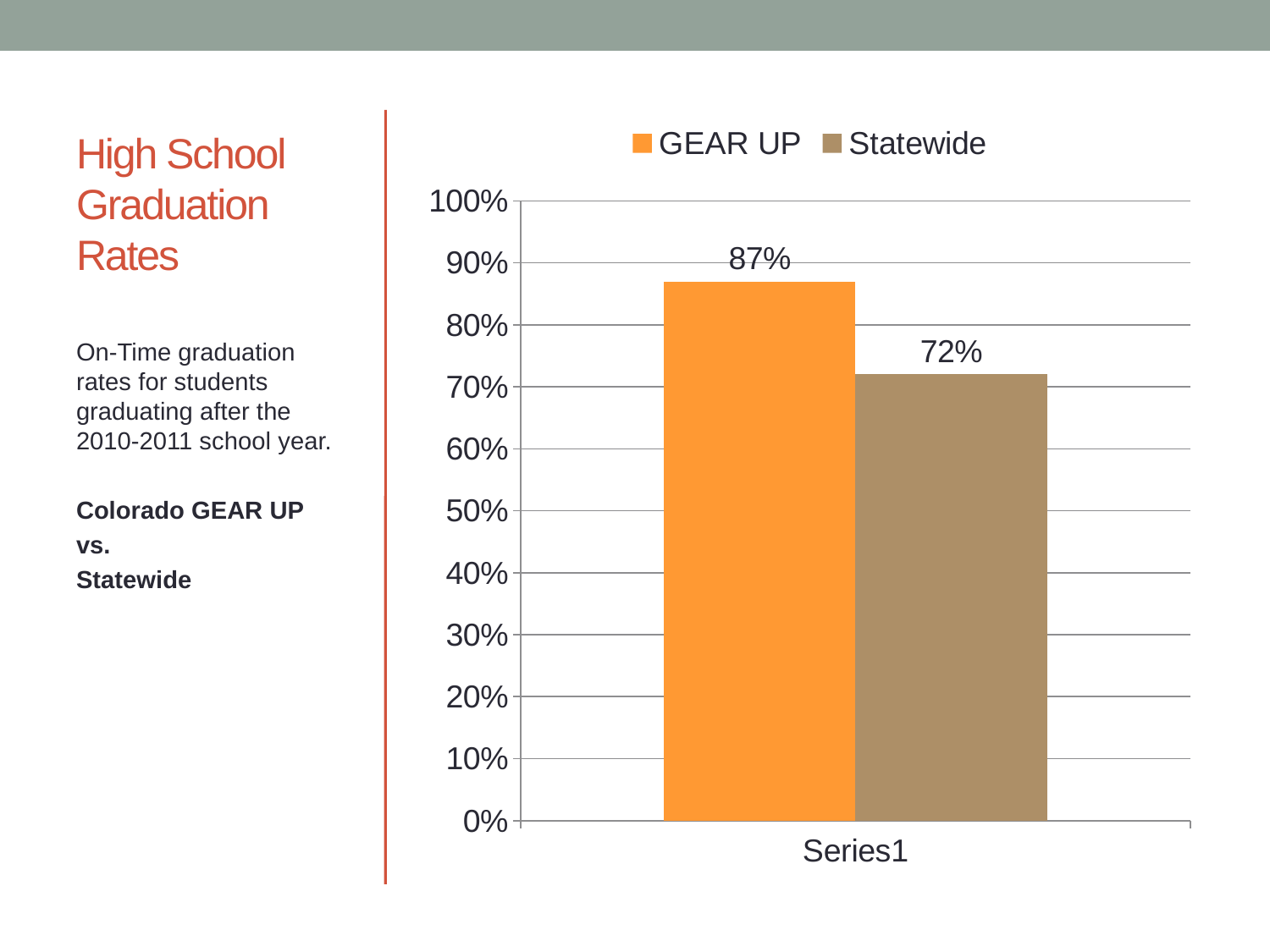
What is the graduation rate shown for GEAR UP? 87% What is the label shown on the x axis beneath the bars? Series1 Which series has the higher graduation rate, GEAR UP or Statewide? GEAR UP Is the value for GEAR UP greater or less than 80%? greater What is the difference between the GEAR UP and Statewide graduation rates? 15% What colour is the GEAR UP bar? orange What kind of chart is shown on the slide? bar chart What is the graduation rate shown for Statewide? 72% Which series has the lowest value on the chart? Statewide Is the value for Statewide greater or less than 80%? less How many series does the legend list? 2 Which series has the highest value on the chart? GEAR UP